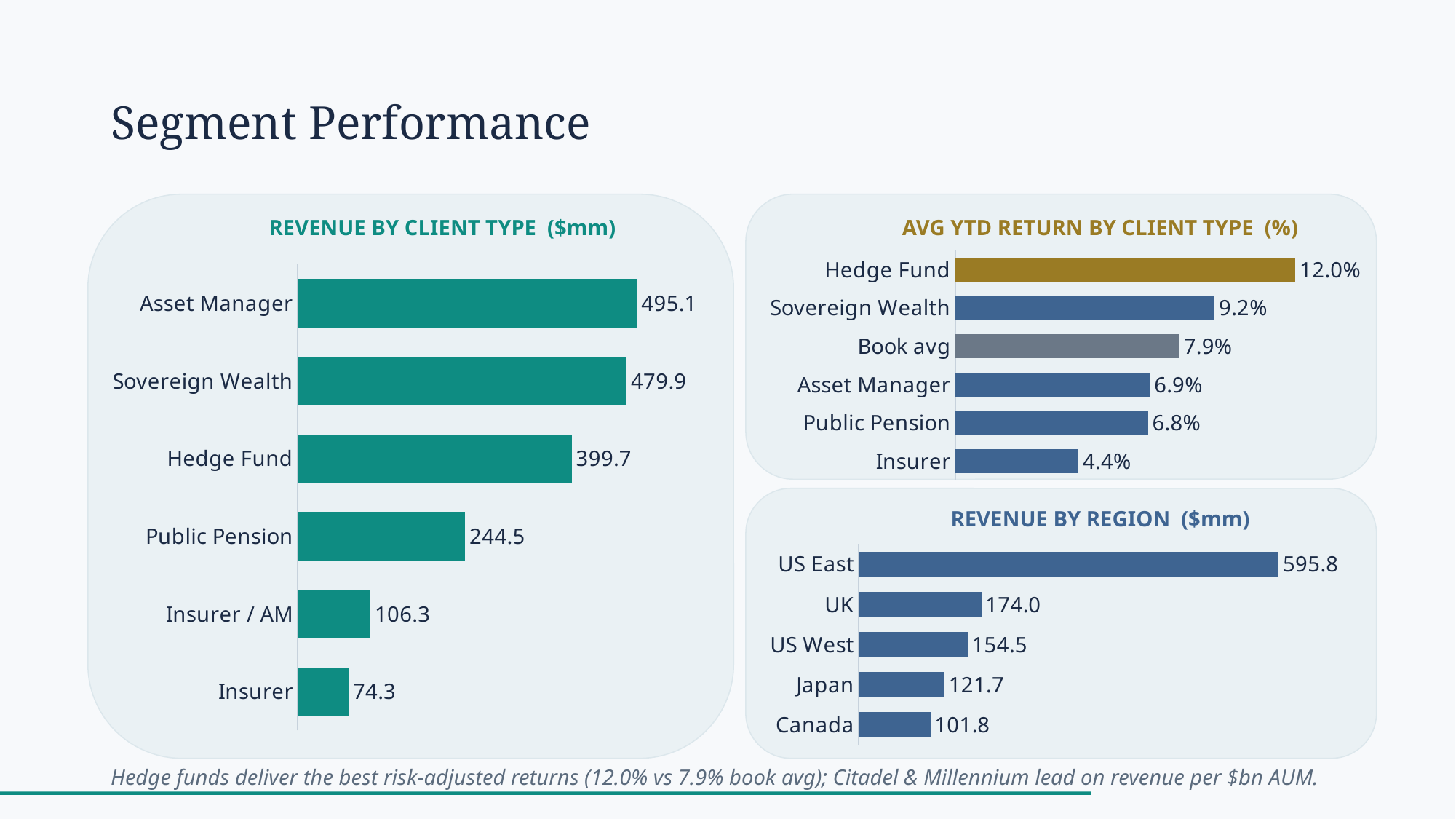
In the 'Revenue by Client Type ($mm)' chart, which client type has the highest revenue? Asset Manager What type of chart is the 'Revenue by Region ($mm)' chart? Bar chart In the 'Revenue by Client Type ($mm)' chart, what is the revenue for Hedge Fund? 399.7 In the 'Avg YTD Return by Client Type (%)' chart, which category has the highest return? Hedge Fund In the 'Revenue by Client Type ($mm)' chart, how many client types are shown? 6 In the 'Revenue by Client Type ($mm)' chart, what is the difference between Asset Manager and Sovereign Wealth revenue? 15.2 In the 'Avg YTD Return by Client Type (%)' chart, what is the difference between the Hedge Fund return and the Book avg? 4.1% In the 'Revenue by Region ($mm)' chart, what is the revenue for Japan? 121.7 In the 'Revenue by Region ($mm)' chart, which region has higher revenue, UK or US West? UK In the 'Revenue by Client Type ($mm)' chart, which client type has the lowest revenue? Insurer In the 'Avg YTD Return by Client Type (%)' chart, what is the average YTD return for Sovereign Wealth? 9.2% In the 'Avg YTD Return by Client Type (%)' chart, which category has the lowest return? Insurer